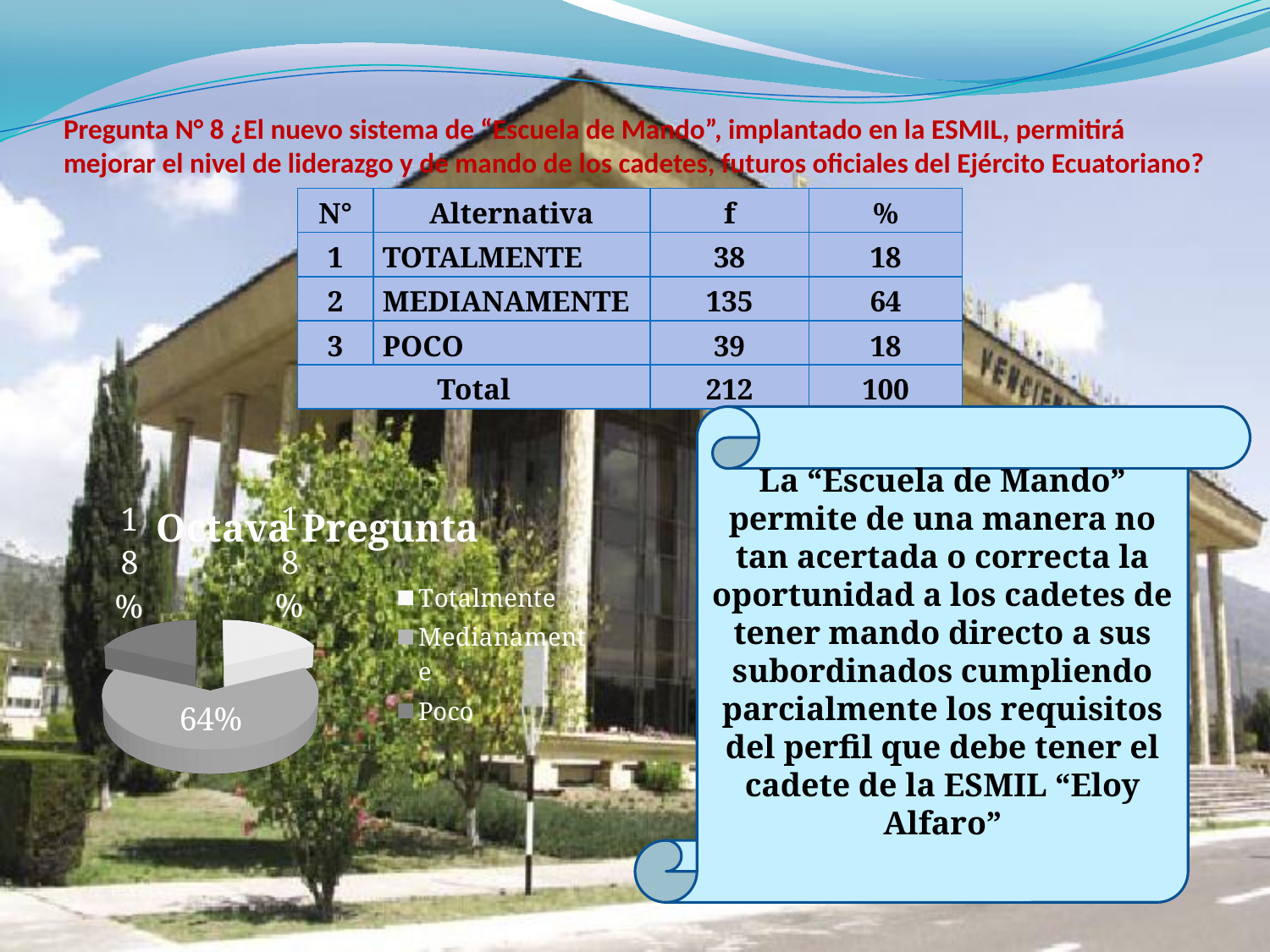
How many slices does the pie chart have? 3 Is the share for Medianamente greater or less than 50%? greater What is the difference in percentage points between the Medianamente slice and the Poco slice? 46 What kind of chart is shown on the slide? pie chart What share of the pie does the Totalmente slice represent? 18% Which category has the largest slice of the pie? Medianamente Which is larger, the Medianamente slice or the Totalmente slice? Medianamente What share of the pie does the Poco slice represent? 18% What is the title of the chart? Octava Pregunta What share of the pie does the Medianamente slice represent? 64% Which legend entry is listed first in the chart's legend? Totalmente How many entries does the chart's legend list? 3